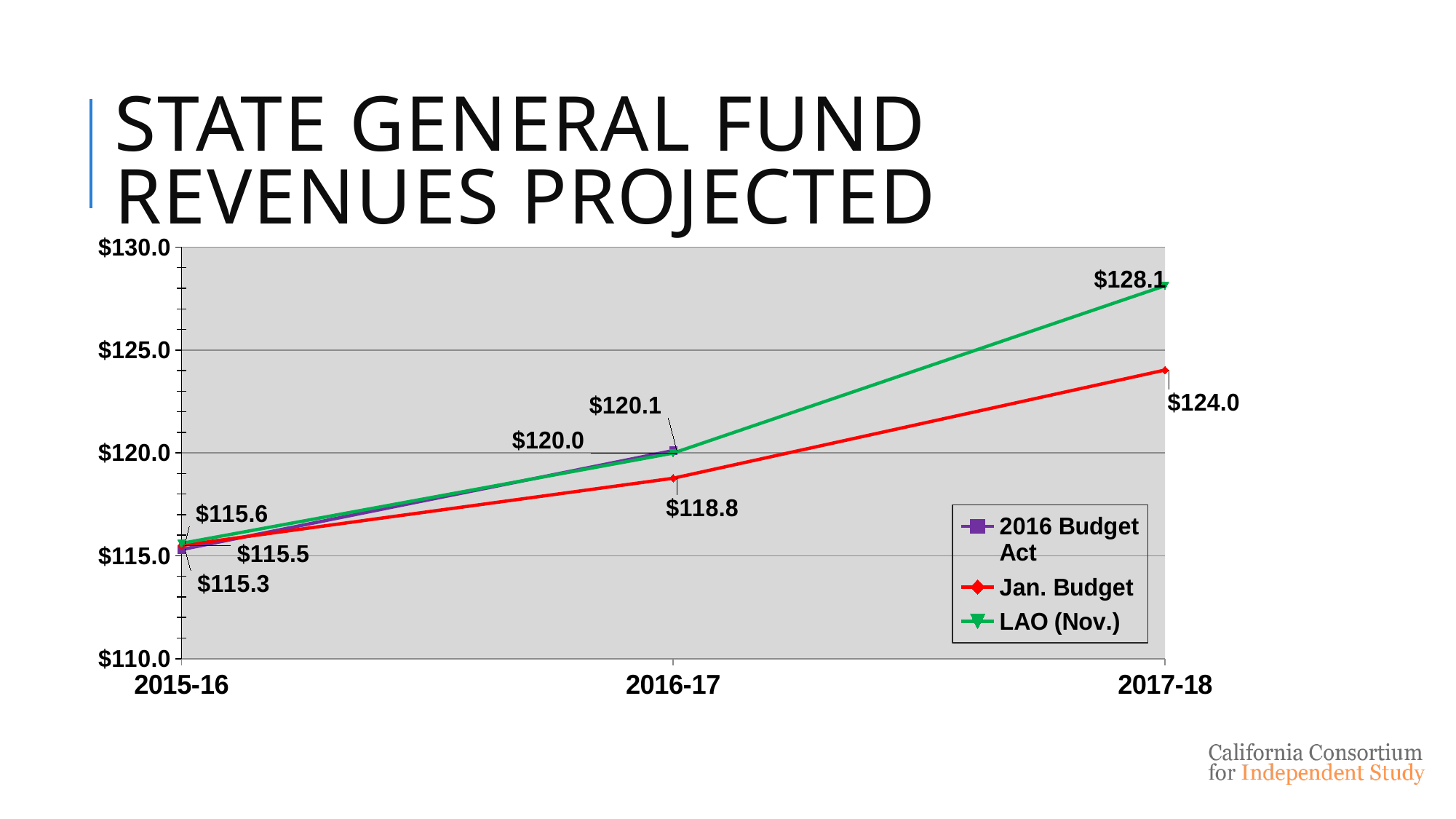
How many series does the legend list? 3 Does the Jan. Budget series rise or fall from 2015-16 to 2017-18? Rise Is the Jan. Budget value for 2017-18 greater or less than $125.0? less How many fiscal years are shown on the x axis? 3 What is the LAO (Nov.) projected value for 2017-18? $128.1 What kind of chart is shown on the slide? Line chart Which series has the higher value for 2017-18, LAO (Nov.) or Jan. Budget? LAO (Nov.) What is the highest value plotted on the chart? $128.1 What is the Jan. Budget projected value for 2017-18? $124.0 What is the difference between the LAO (Nov.) and Jan. Budget values for 2017-18? $4.1 What is the Jan. Budget value for 2016-17? $118.8 By how much does the Jan. Budget value increase from 2016-17 to 2017-18? $5.2